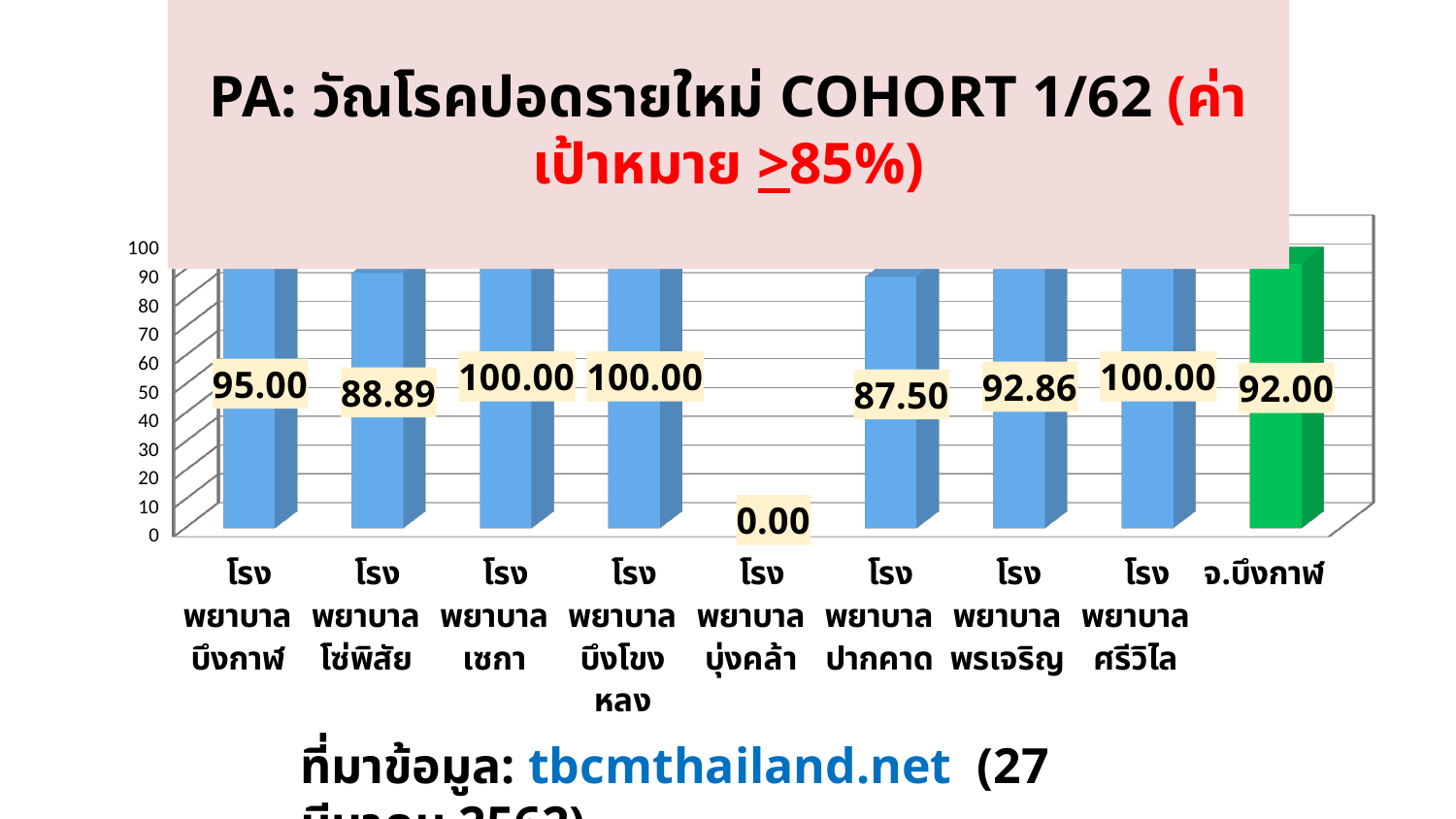
How many categories have a value of 100.00? 3 What is the value for โรงพยาบาลโซ่พิสัย? 88.89 What kind of chart is shown on the slide? bar chart What colour is the bar for จ.บึงกาฬ? green What is the value for โรงพยาบาลบึงกาฬ? 95.00 Which is larger, the value for โรงพยาบาลโซ่พิสัย or โรงพยาบาลพรเจริญ? โรงพยาบาลพรเจริญ How many categories are shown on the x axis? 9 What is the value for โรงพยาบาลพรเจริญ? 92.86 Which category has the lowest value? โรงพยาบาลบุ่งคล้า What is the value for โรงพยาบาลปากคาด? 87.50 What is the difference between the values for โรงพยาบาลบึงกาฬ and โรงพยาบาลปากคาด? 7.50 What is the value for จ.บึงกาฬ? 92.00